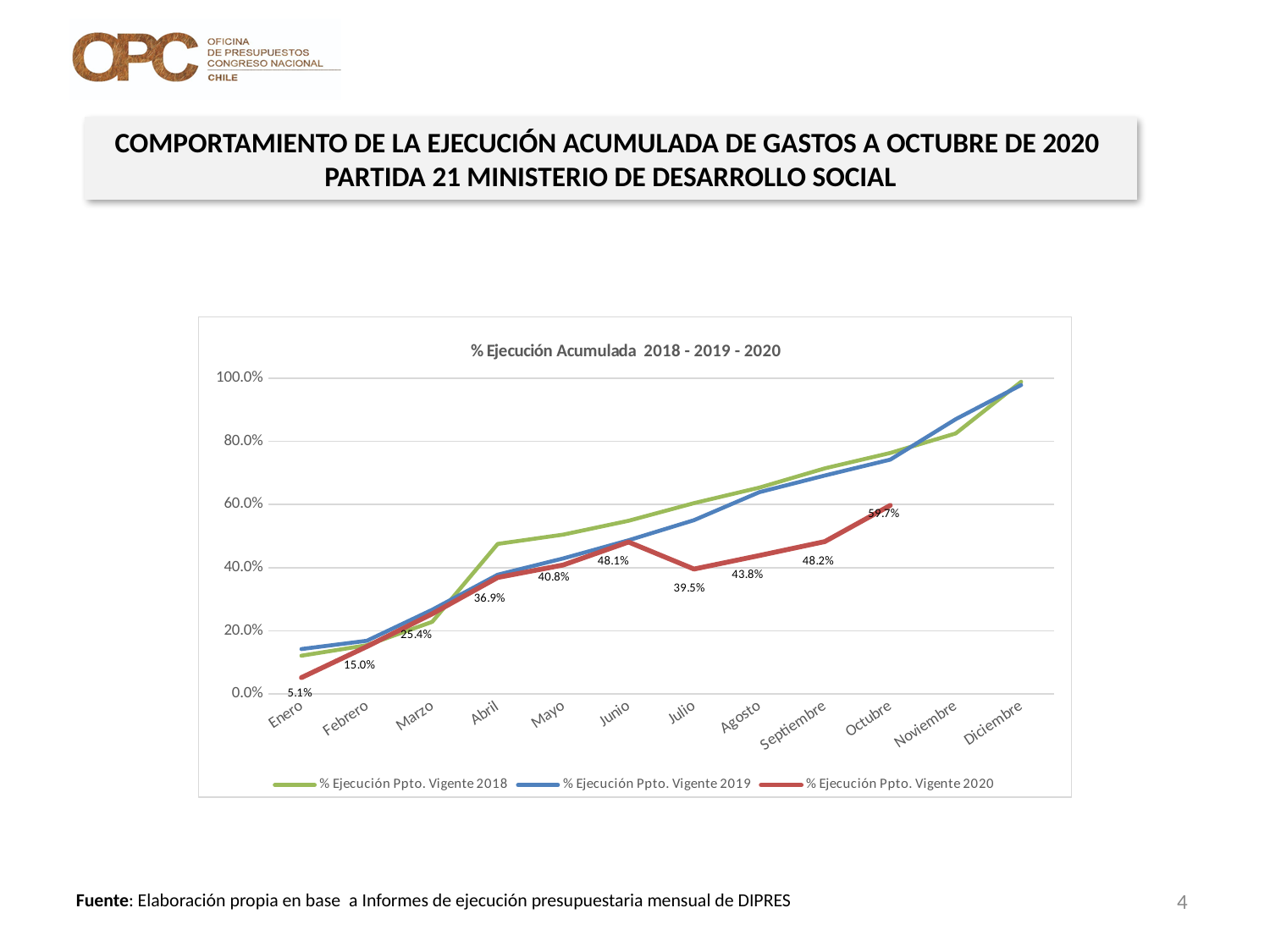
What is the title of the chart? % Ejecución Acumulada 2018 - 2019 - 2020 In which month is the % Ejecución Ppto. Vigente 2020 series at its highest? Octubre Is the value for % Ejecución Ppto. Vigente 2019 in Diciembre greater or less than 80.0%? greater What is the difference between the % Ejecución Ppto. Vigente 2020 values for Octubre and Septiembre? 11.5% In which month is the % Ejecución Ppto. Vigente 2020 series at its lowest? Enero How many series does the legend list? 3 What is the value for % Ejecución Ppto. Vigente 2020 in Enero? 5.1% What is the value for % Ejecución Ppto. Vigente 2020 in Abril? 36.9% What is the value for % Ejecución Ppto. Vigente 2020 in Octubre? 59.7% What type of chart is shown on the slide? line chart What is the value for % Ejecución Ppto. Vigente 2020 in Julio? 39.5% Which is larger for % Ejecución Ppto. Vigente 2020: Junio or Julio? Junio